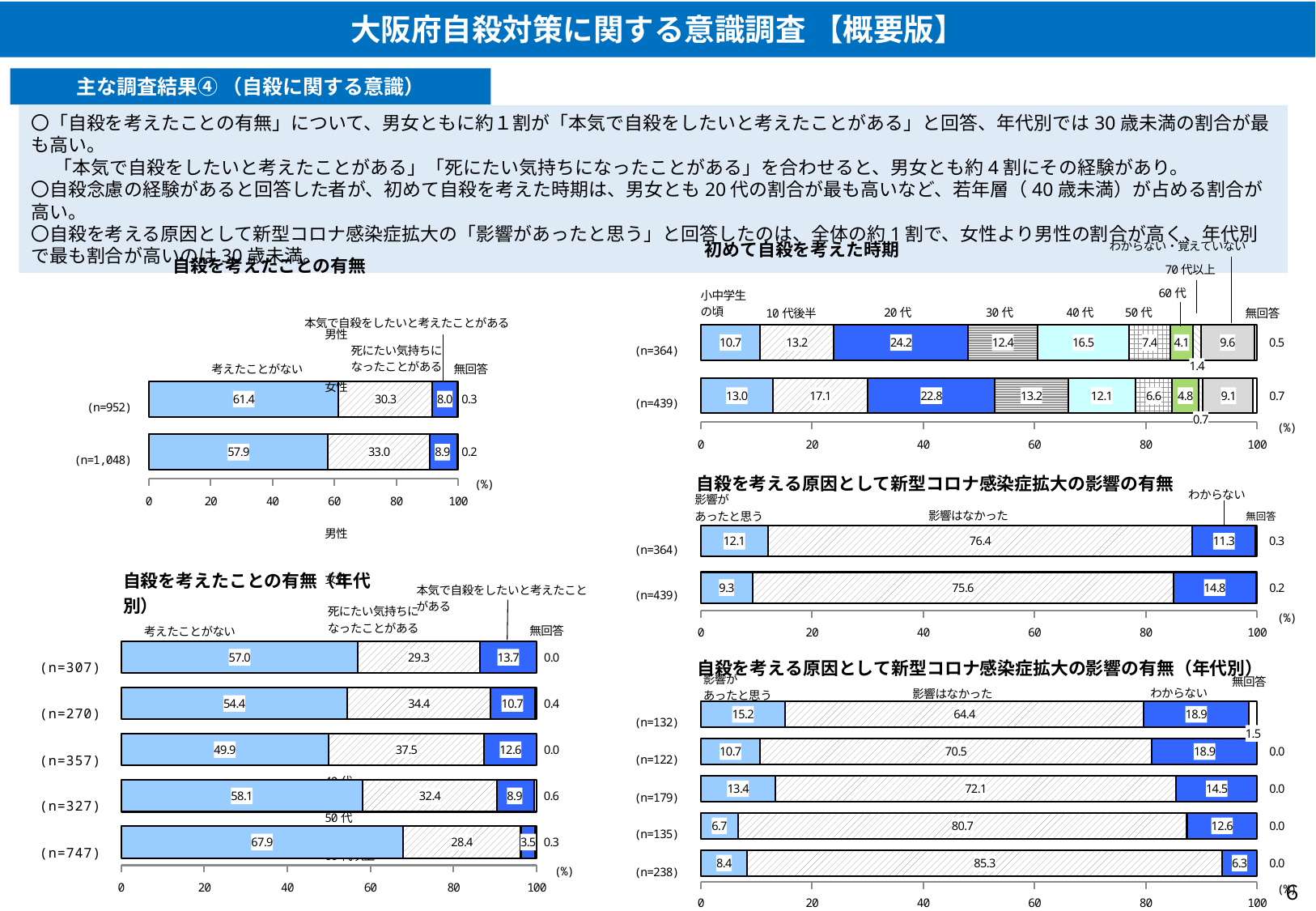
In the chart titled 「初めて自殺を考えた時期」, what is the difference between the 「20代」 values of the n=364 bar and the n=439 bar? 1.4 In the chart titled 「自殺を考える原因として新型コロナ感染症拡大の影響の有無（年代別）」, what is the value of 「影響があったと思う」 for the n=135 bar? 6.7 In the chart titled 「自殺を考えたことの有無」, what is the value of 「考えたことがない」 for the n=952 bar? 61.4 In the chart titled 「自殺を考える原因として新型コロナ感染症拡大の影響の有無」, which bar has the larger 「わからない」 value, n=364 or n=439? n=439 In the chart titled 「自殺を考えたことの有無」, what is the value of 「本気で自殺をしたいと考えたことがある」 for the n=1,048 bar? 8.9 How many bars are shown in the chart titled 「自殺を考えたことの有無（年代別）」? 5 In the chart titled 「自殺を考えたことの有無（年代別）」, which bar has the lowest 「本気で自殺をしたいと考えたことがある」 value? n=747 In the chart titled 「自殺を考える原因として新型コロナ感染症拡大の影響の有無（年代別）」, which bar has the highest 「影響はなかった」 value? n=238 In the chart titled 「初めて自殺を考えた時期」, which category has the highest value for the n=364 bar? 20代 In the chart titled 「初めて自殺を考えた時期」, what is the value of 「40代」 for the n=439 bar? 12.1 In the chart titled 「自殺を考える原因として新型コロナ感染症拡大の影響の有無」, what is the value of 「影響があったと思う」 for the n=439 bar? 9.3 What type of chart is 「初めて自殺を考えた時期」? Stacked bar chart